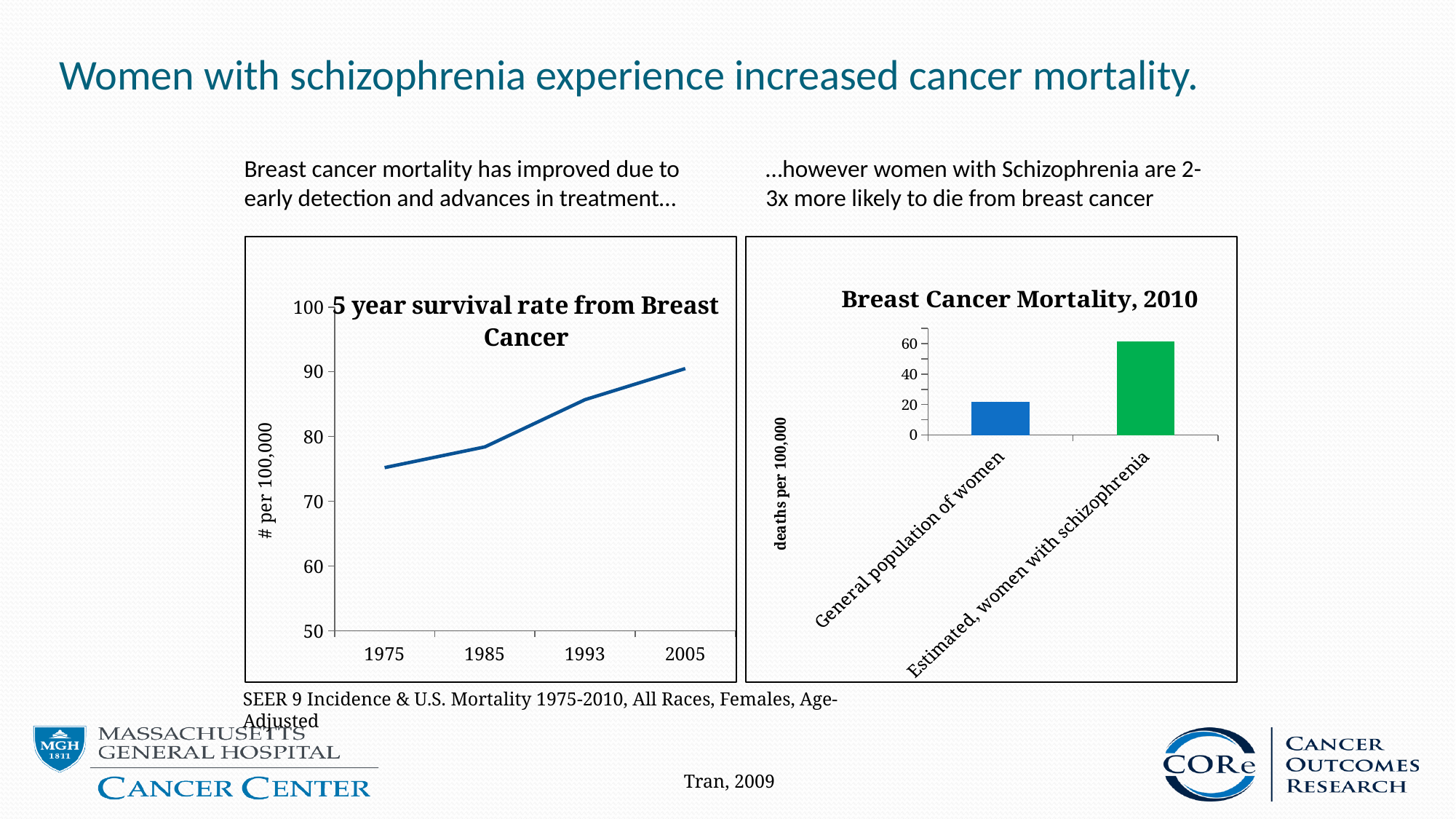
In the chart titled "5 year survival rate from Breast Cancer", how many years are labelled on the x axis? 4 In the chart titled "5 year survival rate from Breast Cancer", is the value for 1975 greater or less than 80? less In the chart titled "Breast Cancer Mortality, 2010", which category has the highest value? Estimated, women with schizophrenia In the chart titled "Breast Cancer Mortality, 2010", is the value for Estimated, women with schizophrenia greater or less than 40? greater In the chart titled "5 year survival rate from Breast Cancer", does the survival rate rise or fall from 1975 to 2005? rise In the chart titled "5 year survival rate from Breast Cancer", what kind of chart is shown? line chart In the chart titled "Breast Cancer Mortality, 2010", what is the label on the vertical axis? deaths per 100,000 In the chart titled "Breast Cancer Mortality, 2010", is the value for General population of women greater or less than 40? less In the chart titled "Breast Cancer Mortality, 2010", what kind of chart is shown? bar chart In the chart titled "5 year survival rate from Breast Cancer", which year has the highest survival rate? 2005 In the chart titled "Breast Cancer Mortality, 2010", how many categories are shown? 2